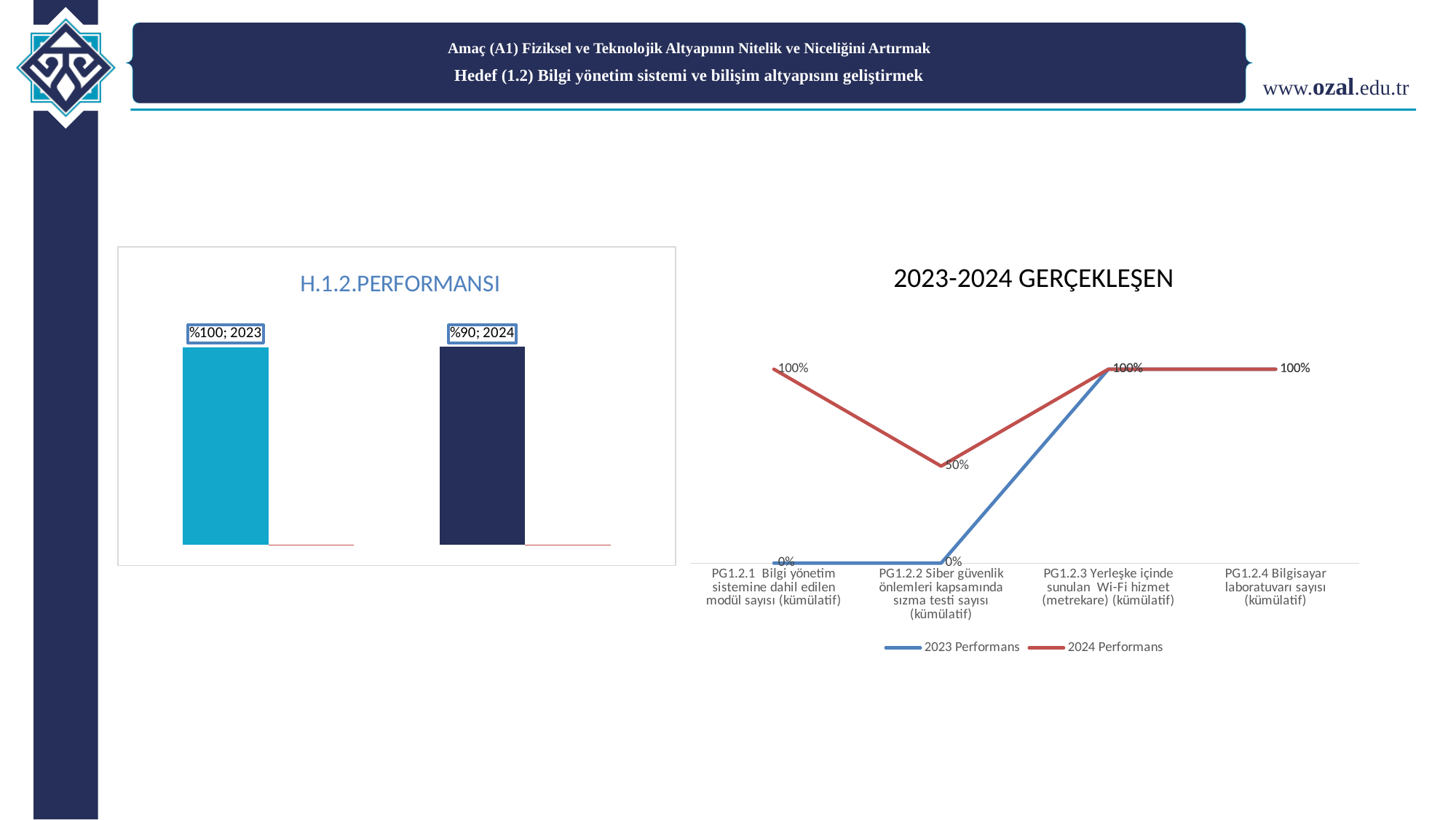
In the 2023-2024 GERÇEKLEŞEN chart, what is the 2024 Performans value for PG1.2.1 Bilgi yönetim sistemine dahil edilen modül sayısı (kümülatif)? 100% In the H.1.2.PERFORMANSI chart, which year has the higher value? 2023 In the 2023-2024 GERÇEKLEŞEN chart, what is the 2024 Performans value for PG1.2.2 Siber güvenlik önlemleri kapsamında sızma testi sayısı (kümülatif)? 50% What kind of chart is the 2023-2024 GERÇEKLEŞEN chart? Line chart How many bars are shown in the H.1.2.PERFORMANSI chart? 2 In the 2023-2024 GERÇEKLEŞEN chart, what is the 2023 Performans value for PG1.2.1 Bilgi yönetim sistemine dahil edilen modül sayısı (kümülatif)? 0% In the H.1.2.PERFORMANSI chart, what is the value for 2023? %100 In the H.1.2.PERFORMANSI chart, what is the value for 2024? %90 What kind of chart is the H.1.2.PERFORMANSI chart? Bar chart In the 2023-2024 GERÇEKLEŞEN chart, how many categories are shown on the x axis? 4 In the H.1.2.PERFORMANSI chart, what is the difference between the 2023 and 2024 values? %10 How many series does the legend of the 2023-2024 GERÇEKLEŞEN chart list? 2